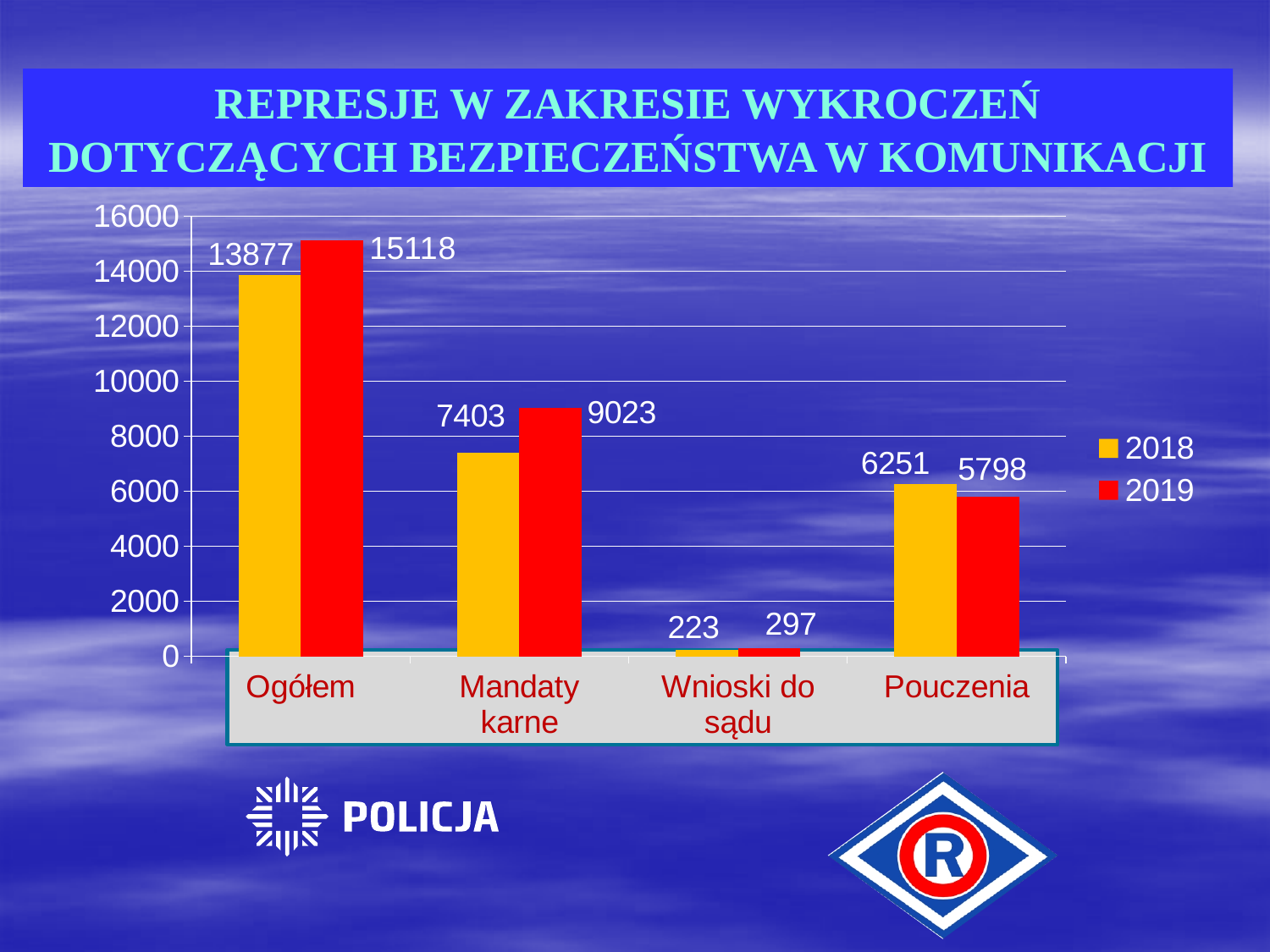
What is the difference between the 2019 and 2018 values for Mandaty karne? 1620 What is the value for Ogółem in 2019? 15118 How many categories are shown on the x axis? 4 Which category has the lowest value in 2018? Wnioski do sądu What is the value for Mandaty karne in 2018? 7403 How many series does the legend list? 2 Which category has the highest value in 2019? Ogółem What is the value for Wnioski do sądu in 2019? 297 What is the value for Pouczenia in 2018? 6251 Which colour represents the 2019 series? red Which is larger for Pouczenia, the 2018 value or the 2019 value? 2018 What kind of chart is shown on the slide? bar chart